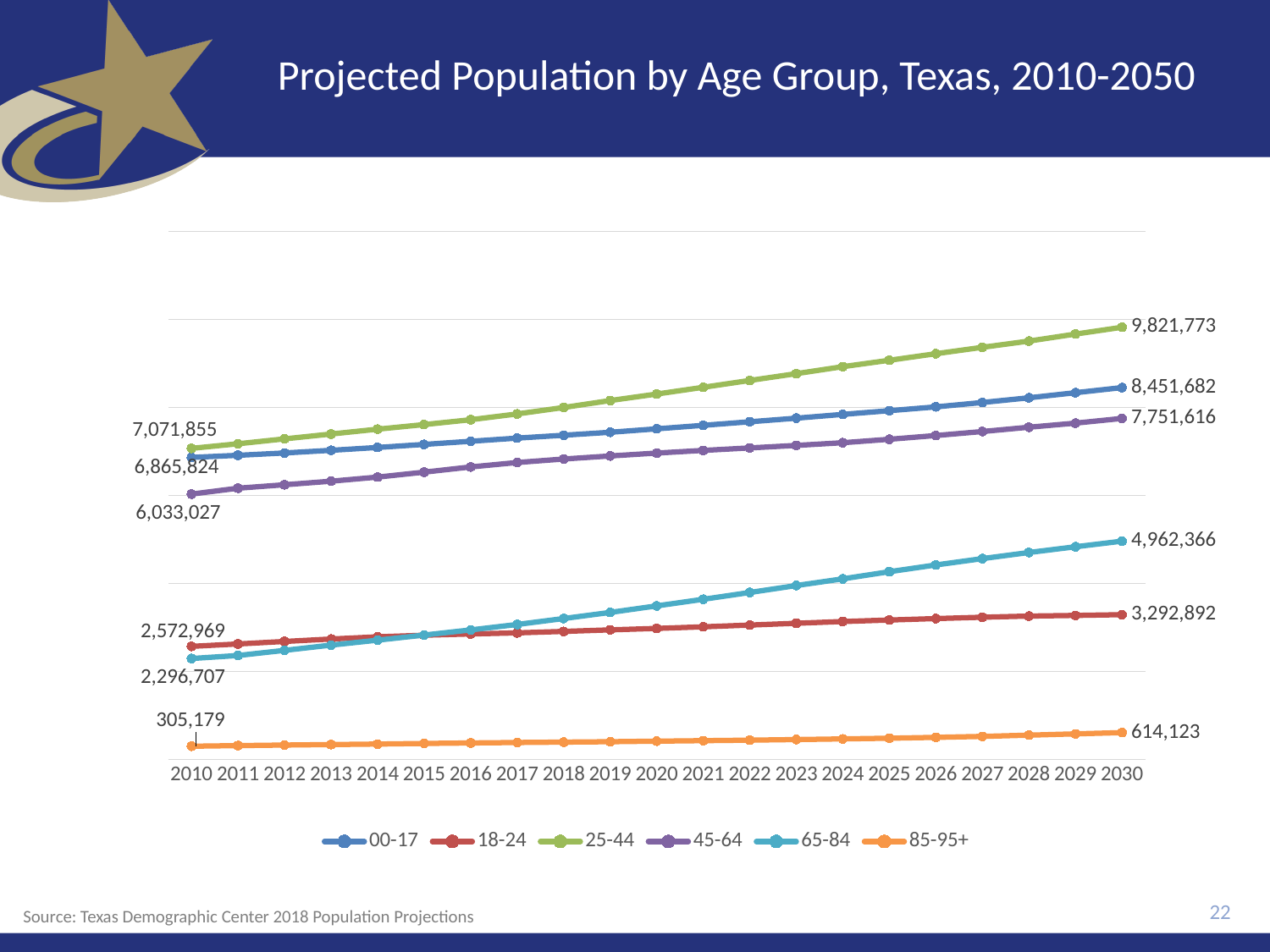
What kind of chart is shown on the slide? Line chart What is the projected population for the 65-84 age group in 2030? 4,962,366 By how much does the 65-84 age group's population increase from 2010 to 2030? 2,665,659 Does the population of the 45-64 age group rise or fall from 2010 to 2030? Rise In 2030, which is larger: the projected population of the 18-24 group or the 65-84 group? 65-84 Which age group has the highest projected population in 2030? 25-44 How many age groups does the legend list? 6 What is the projected population for the 25-44 age group in 2030? 9,821,773 What is the population for the 85-95+ age group in 2010? 305,179 Which age group has the lowest population in 2010? 85-95+ How many years are shown on the x axis? 21 What is the population for the 00-17 age group in 2010? 6,865,824